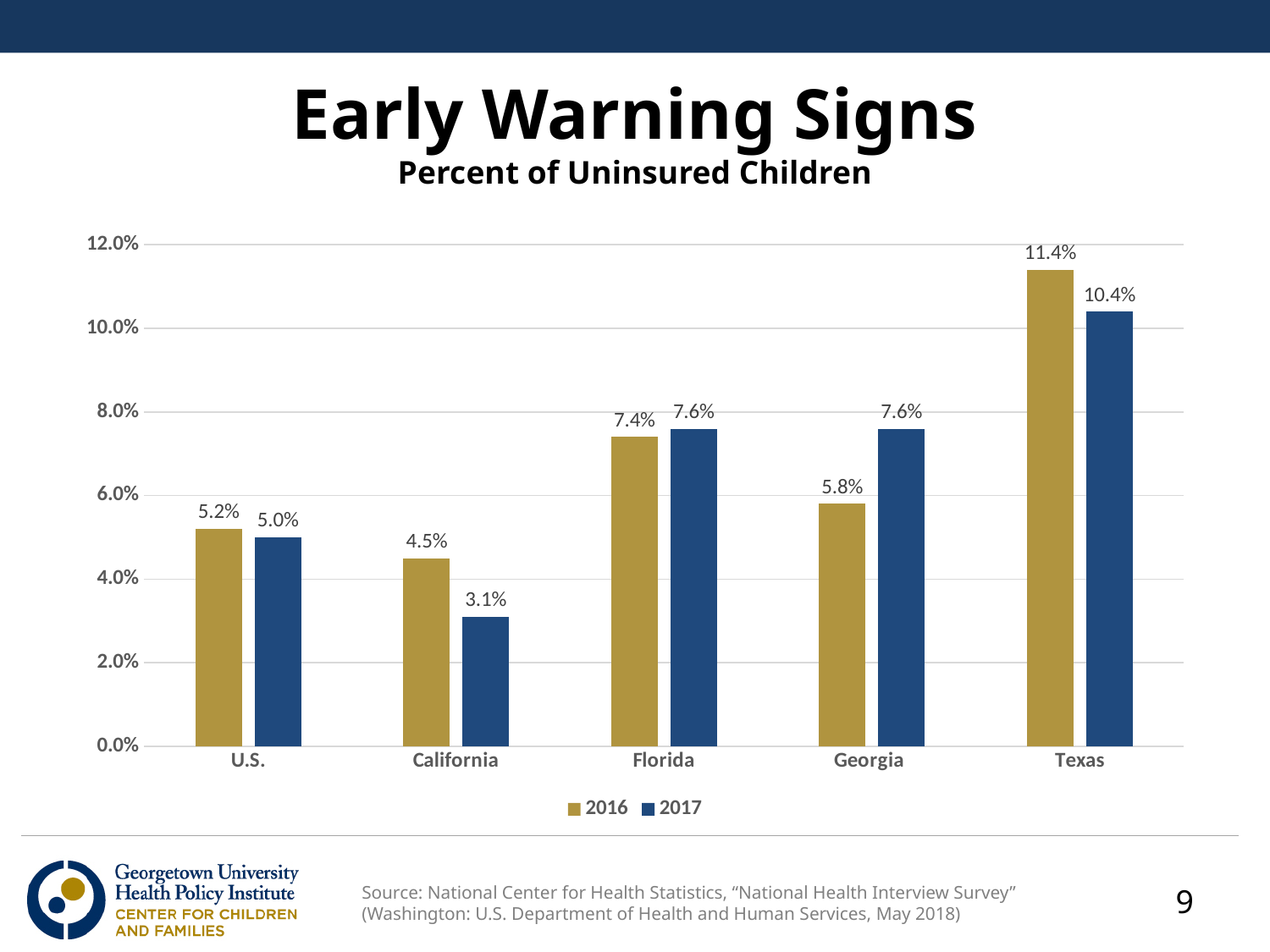
Which state or region had the lowest percent of uninsured children in 2017? California What is the difference between the Texas and U.S. values for 2016? 6.2% Which year does the gold-colored series represent? 2016 What was the percent of uninsured children in Texas in 2016? 11.4% How many series does the legend list? 2 What was the percent of uninsured children in California in 2017? 3.1% What is the difference between the 2016 and 2017 values for Georgia? 1.8% What kind of chart is shown on the slide? Bar chart Which is larger, the 2017 value for Florida or the 2017 value for U.S.? Florida Which state or region had the highest percent of uninsured children in 2017? Texas What was the percent of uninsured children in Georgia in 2016? 5.8% How many states or regions are shown on the x axis? 5